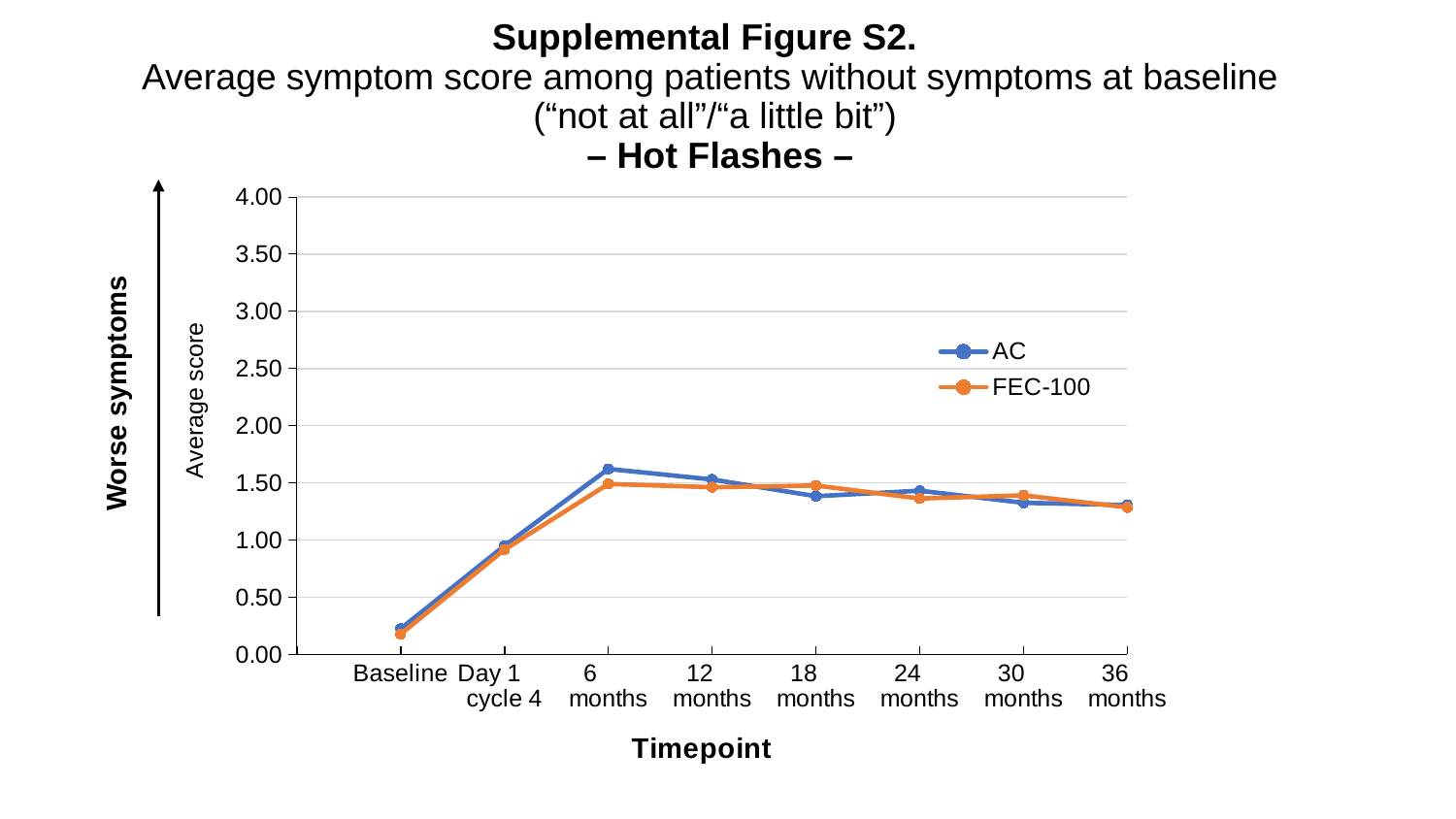
At which timepoint does the AC series reach its highest value? 6 months Which series are listed in the legend? AC and FEC-100 Do the values for AC rise or fall from Baseline to 6 months? Rise Is the value for AC at 6 months greater or less than 1.50? greater At 6 months, which series has the higher value, AC or FEC-100? AC What is the label of the vertical axis? Average score How many series does the legend list? 2 Is the value for FEC-100 at Baseline greater or less than 0.50? less Is the value for AC at 18 months greater or less than 1.50? less What kind of chart is shown on the slide? Line chart How many timepoints are plotted along the x axis? 8 At which timepoint is the FEC-100 series at its lowest value? Baseline